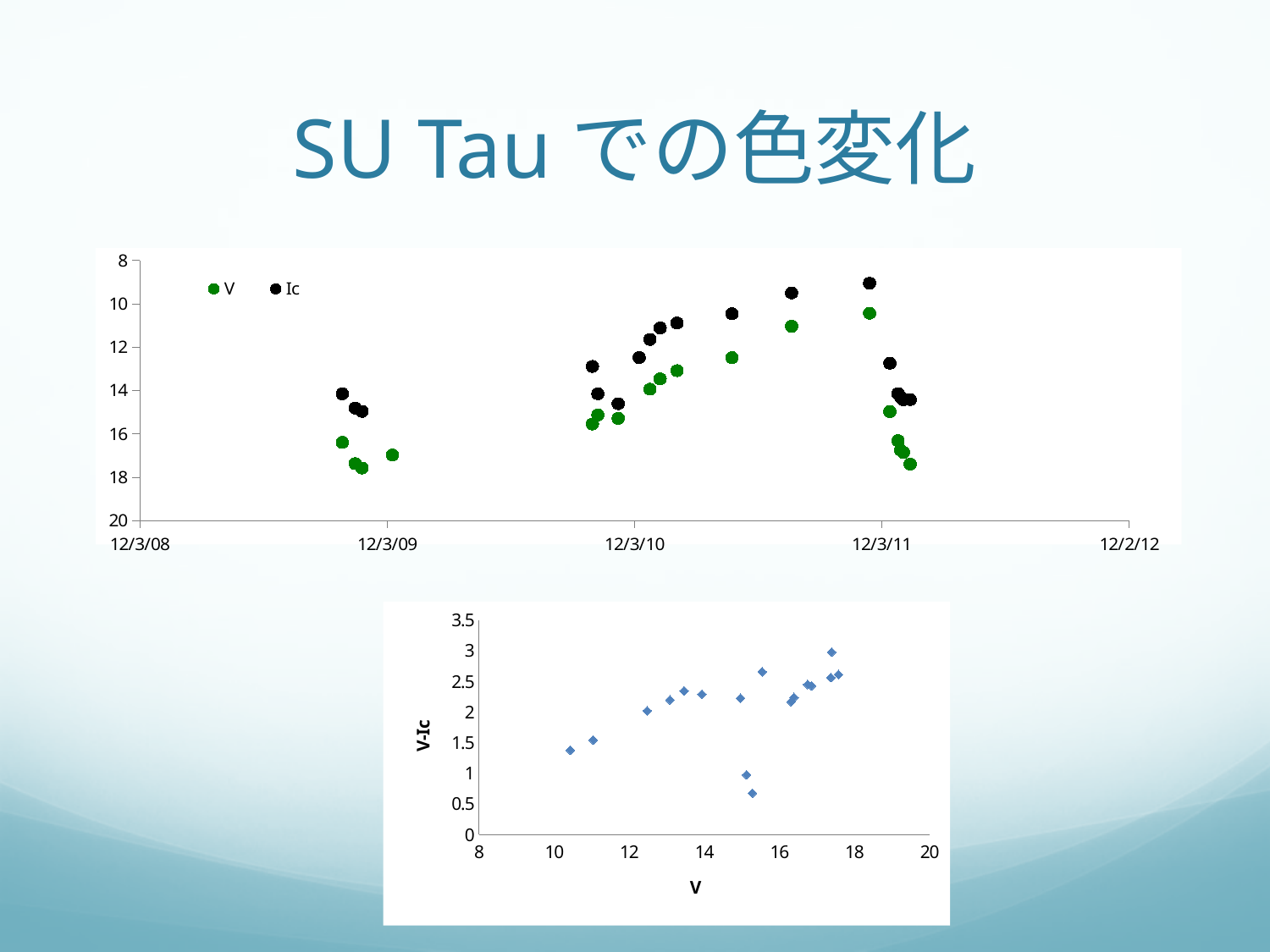
In the top chart, are the Ic points plotted above or below the V points? above How many series does the legend of the top chart list? 2 What are the two series named in the legend of the top chart? V and Ic In the top chart, is the highest Ic point near 12/3/11 greater or less than 10? less In the bottom chart, do the V-Ic values generally rise or fall as V increases? rise In the top chart, is the lowest V point near 12/3/09 greater or less than 16? greater In the bottom chart, is the highest V-Ic value greater or less than 2.5? greater What kind of chart is the top chart on the slide? scatter chart What kind of chart is the bottom chart on the slide? scatter chart What is the label of the vertical axis of the bottom chart? V-Ic